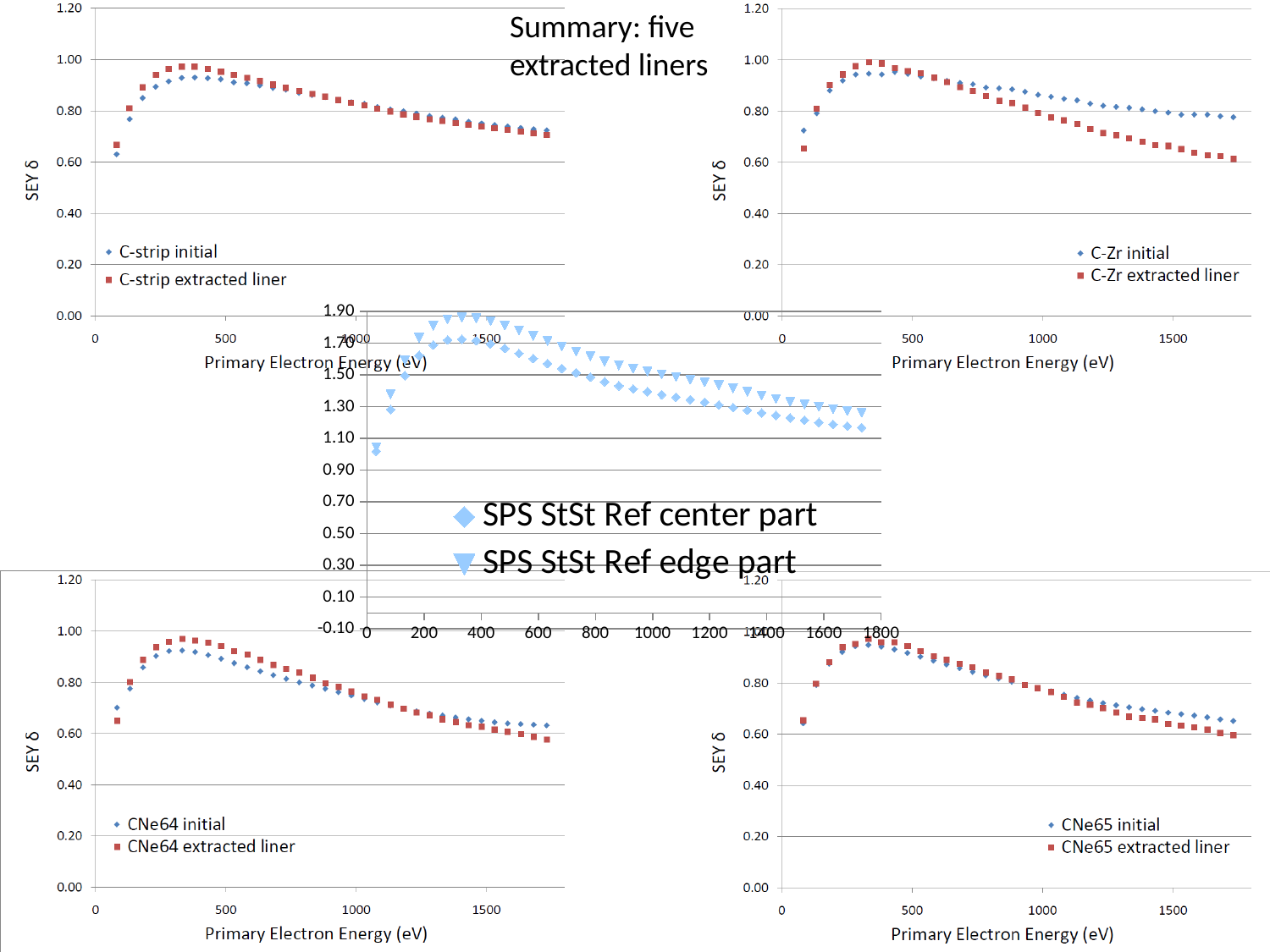
How many series does the legend of the top-right chart (C-Zr) list? 2 What kind of chart is the top-left chart (C-strip)? scatter chart In the bottom-left chart (CNe64), do the values of CNe64 extracted liner rise or fall from 500 eV to 1500 eV? fall In the center chart (SPS StSt Ref), which series has the higher value at 1000 eV, center part or edge part? SPS StSt Ref edge part In the bottom-right chart (CNe65), is the value of CNe65 extracted liner at 1500 eV greater or less than 0.80? less In the center chart (SPS StSt Ref), is the value of SPS StSt Ref edge part at 1600 eV greater or less than 1.50? less What is the y-axis label on the bottom-left chart (CNe64)? SEY δ In the top-left chart (C-strip), is the value of C-strip extracted liner at 1500 eV greater or less than 0.80? less In the center chart (SPS StSt Ref), what are the two legend entries? SPS StSt Ref center part; SPS StSt Ref edge part In the top-right chart (C-Zr), which series has the higher value at 1500 eV, C-Zr initial or C-Zr extracted liner? C-Zr initial